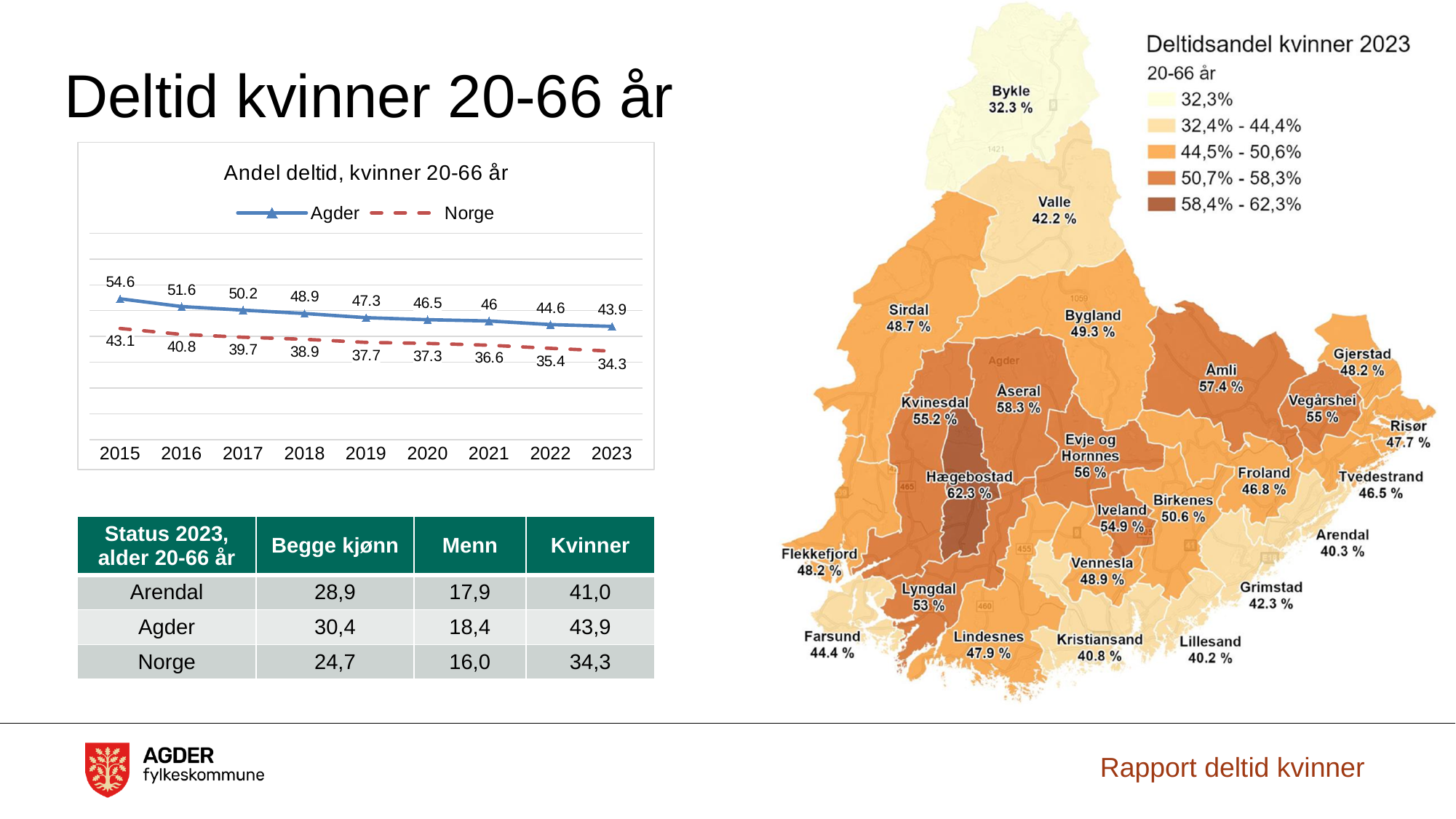
In the chart 'Andel deltid, kvinner 20-66 år', what is the value for Agder in 2019? 47.3 In the chart 'Andel deltid, kvinner 20-66 år', what is the value for Agder in 2015? 54.6 In the chart 'Andel deltid, kvinner 20-66 år', do the Agder values rise or fall from 2015 to 2023? Fall In the chart 'Andel deltid, kvinner 20-66 år', what is the difference between Agder and Norge in 2023? 9.6 How many series does the legend of the chart 'Andel deltid, kvinner 20-66 år' list? 2 In the chart 'Andel deltid, kvinner 20-66 år', which series has the larger value in 2020, Agder or Norge? Agder How many years are shown on the x axis of the chart 'Andel deltid, kvinner 20-66 år'? 9 What kind of chart is 'Andel deltid, kvinner 20-66 år'? Line chart In the chart 'Andel deltid, kvinner 20-66 år', which year has the lowest value for Norge? 2023 In the chart 'Andel deltid, kvinner 20-66 år', what is the value for Norge in 2023? 34.3 In the chart 'Andel deltid, kvinner 20-66 år', which year has the highest value for Agder? 2015 In the chart 'Andel deltid, kvinner 20-66 år', what is the value for Norge in 2017? 39.7